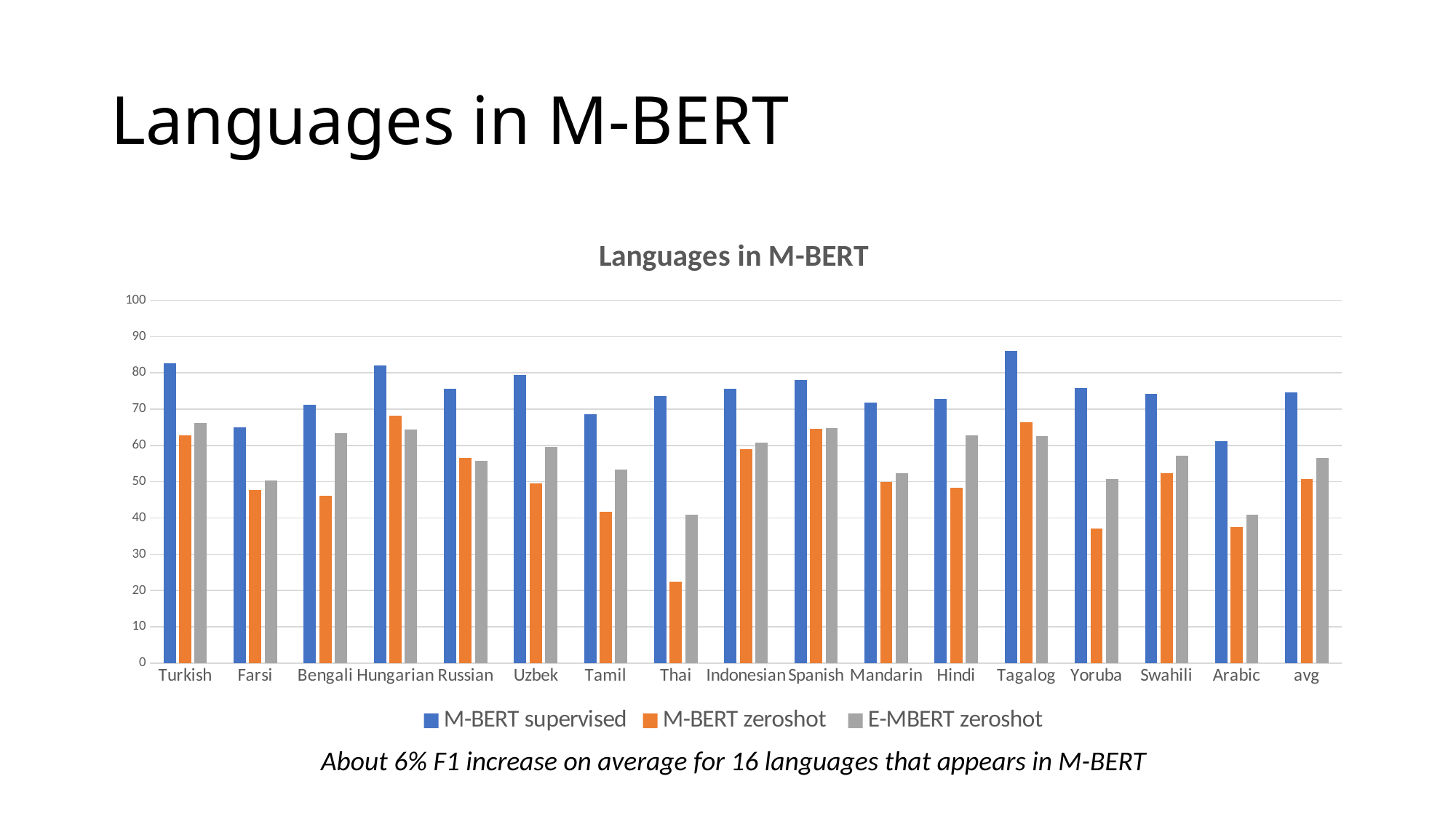
For Turkish, which is larger: the M-BERT zeroshot value or the E-MBERT zeroshot value? E-MBERT zeroshot Which language has the lowest M-BERT supervised value? Arabic Which language has the lowest M-BERT zeroshot value? Thai How many categories are shown on the x axis? 17 Is the M-BERT zeroshot value for Yoruba greater or less than 40? less Which language has the highest M-BERT supervised value? Tagalog Is the M-BERT zeroshot value for Thai greater or less than 30? less What kind of chart is shown on the slide? bar chart What is the title of the chart? Languages in M-BERT How many series does the legend list? 3 For Thai, which is larger: the M-BERT zeroshot value or the E-MBERT zeroshot value? E-MBERT zeroshot Is the M-BERT supervised value for Tagalog greater or less than 80? greater